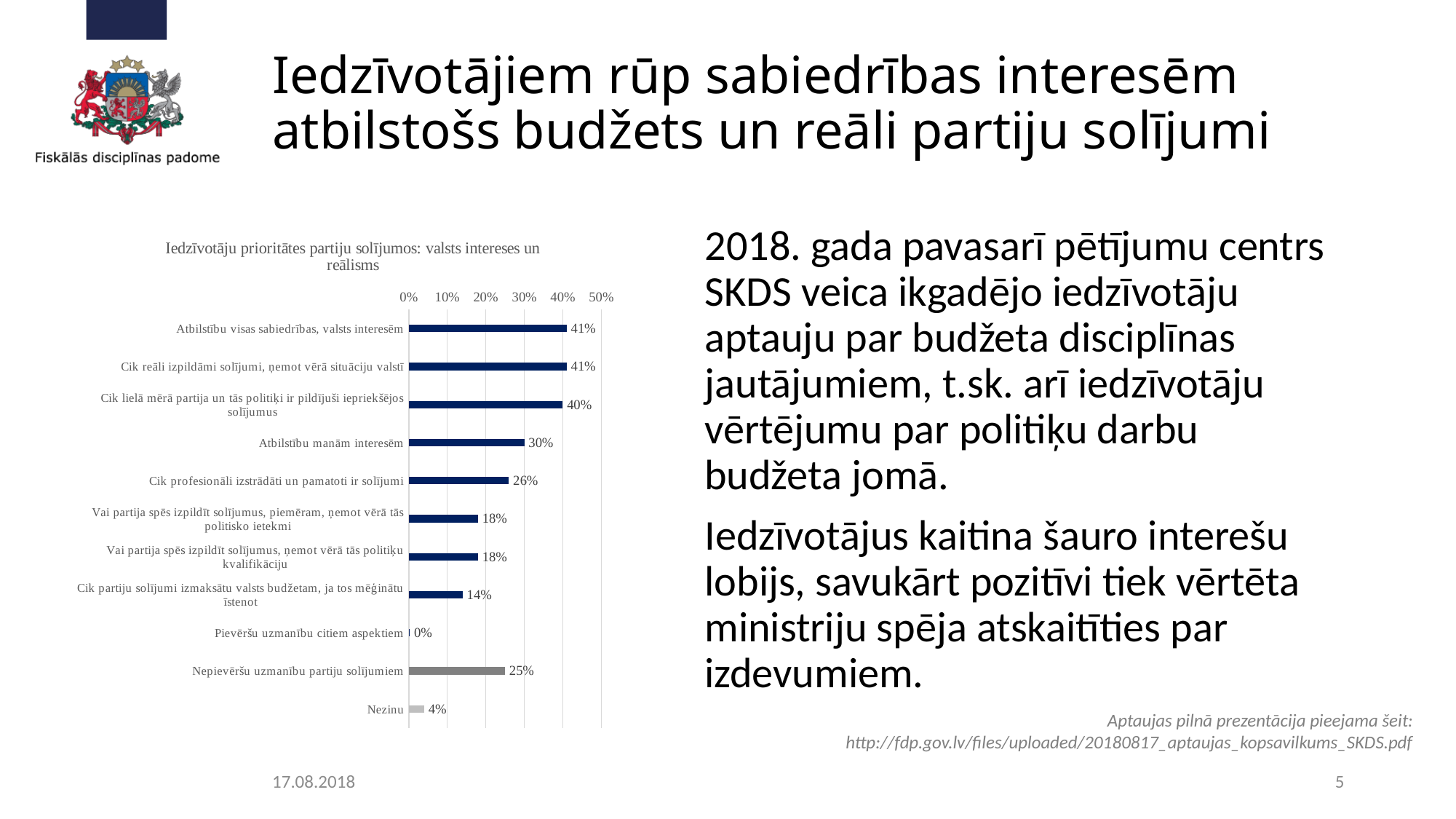
Is the value for "Cik lielā mērā partija un tās politiķi ir pildījuši iepriekšējos solījumus" greater or less than 30%? greater Which category has the lowest value? Pievēršu uzmanību citiem aspektiem Which is larger: "Cik profesionāli izstrādāti un pamatoti ir solījumi" or "Nepievēršu uzmanību partiju solījumiem"? Cik profesionāli izstrādāti un pamatoti ir solījumi What is the title of the chart? Iedzīvotāju prioritātes partiju solījumos: valsts intereses un reālisms What is the value for "Nepievēršu uzmanību partiju solījumiem"? 25% What is the value for "Nezinu"? 4% What is the value for "Cik partiju solījumi izmaksātu valsts budžetam, ja tos mēģinātu īstenot"? 14% What is the value for "Atbilstību manām interesēm"? 30% How many categories are shown in the chart? 11 What is the difference between "Atbilstību visas sabiedrības, valsts interesēm" and "Atbilstību manām interesēm"? 11% What kind of chart is shown on the slide? Bar chart What is the value for "Cik profesionāli izstrādāti un pamatoti ir solījumi"? 26%